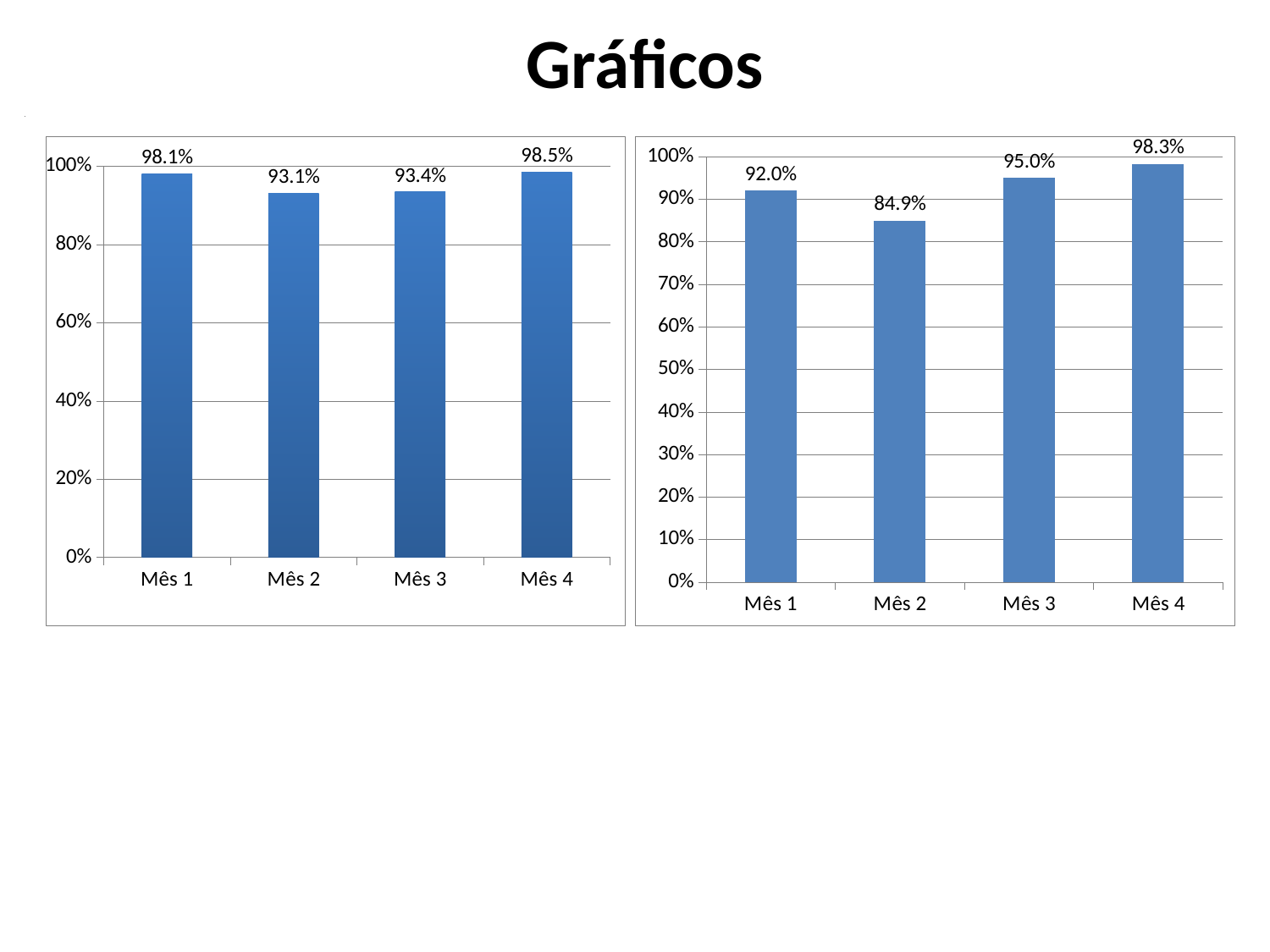
In the right chart, what is the difference between the values for Mês 4 and Mês 2? 13.4% What is the title of the slide? Gráficos In the right chart, which month has the lowest value? Mês 2 In the right chart, what is the value for Mês 2? 84.9% In the left chart, which is larger, the value for Mês 2 or the value for Mês 3? Mês 3 How many categories are shown on the x axis of the right chart? 4 What kind of chart is the left chart? bar chart In the left chart, what is the value for Mês 1? 98.1% In the left chart, which month has the highest value? Mês 4 In the left chart, what is the difference between the values for Mês 1 and Mês 2? 5.0% In the right chart, do the values rise or fall from Mês 2 to Mês 4? rise In the right chart, is the value for Mês 2 greater or less than 90%? less